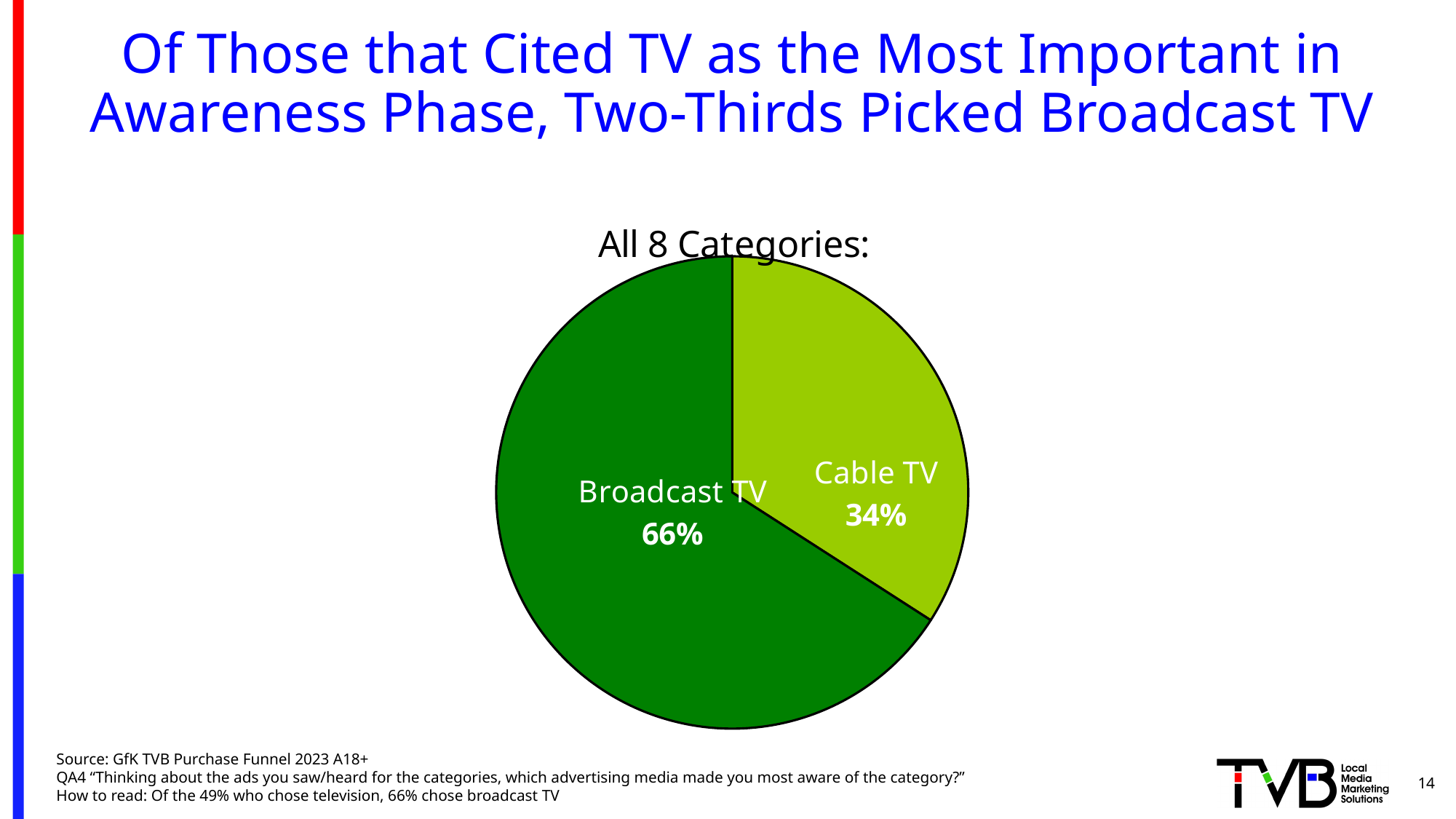
Which slice of the pie is the largest? Broadcast TV Which is larger, the Broadcast TV slice or the Cable TV slice? Broadcast TV How many slices does the pie chart have? 2 What is the total of the two slices shown in the pie chart? 100% What share of the pie does Cable TV account for? 34% What colour is the Cable TV slice? light green What is the title shown above the pie chart? All 8 Categories: What share of the pie does Broadcast TV account for? 66% Which slice of the pie is the smallest? Cable TV What is the difference in percentage points between the Broadcast TV and Cable TV slices? 32 What kind of chart is shown on the slide? pie chart